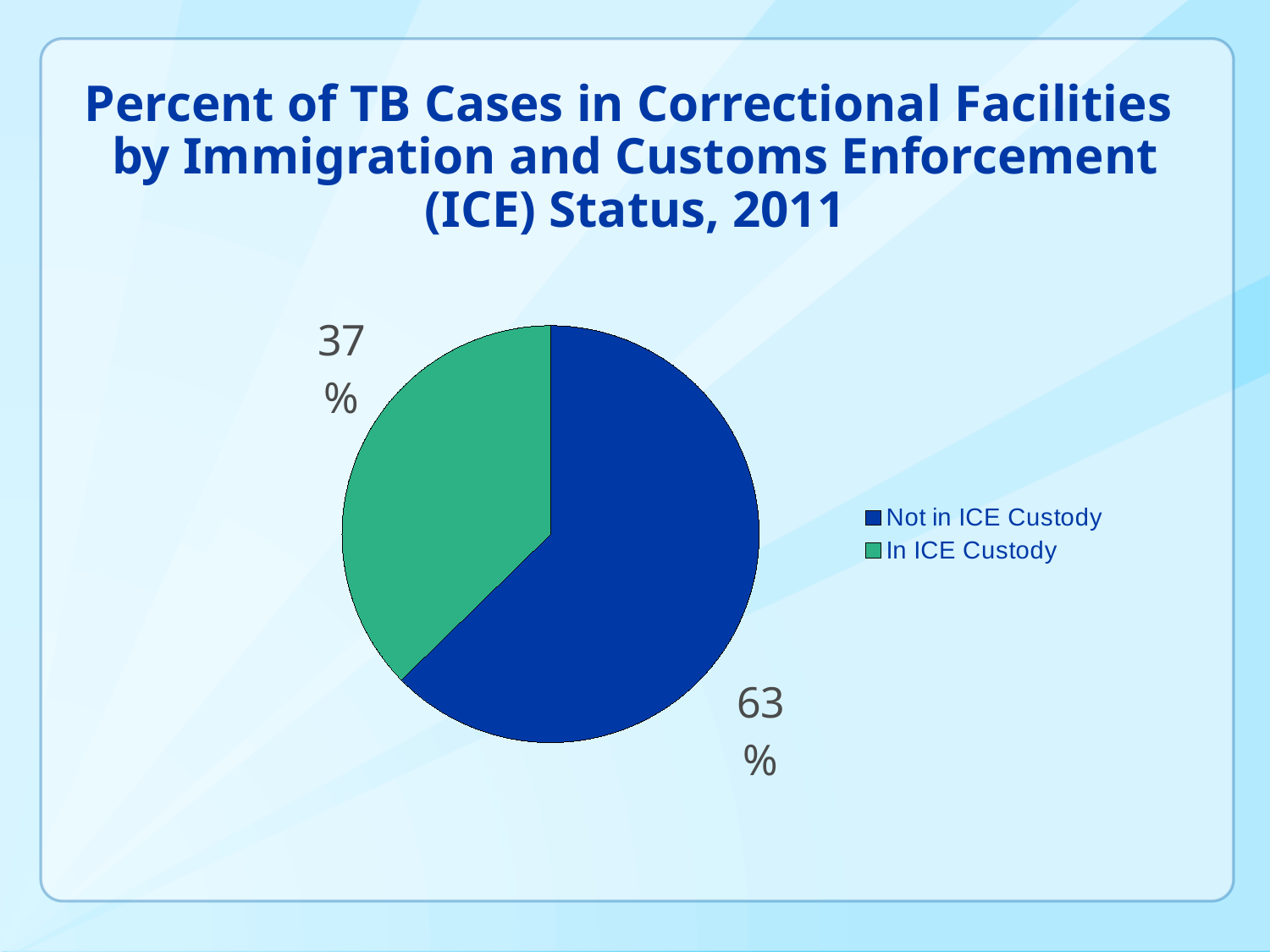
What colour is the Not in ICE Custody slice? Blue What percentage of TB cases in correctional facilities were In ICE Custody? 37% How many categories does the pie chart show? 2 How many entries does the legend list? 2 Which category has the largest share of the pie? Not in ICE Custody What percentage of TB cases in correctional facilities were Not in ICE Custody? 63% What share of the pie does the In ICE Custody slice represent? 37% Which category has the smallest share of the pie? In ICE Custody What year does the chart title refer to? 2011 What is the difference in percentage points between Not in ICE Custody and In ICE Custody? 26 Which is larger, the share for In ICE Custody or the share for Not in ICE Custody? Not in ICE Custody What kind of chart is shown on the slide? Pie chart